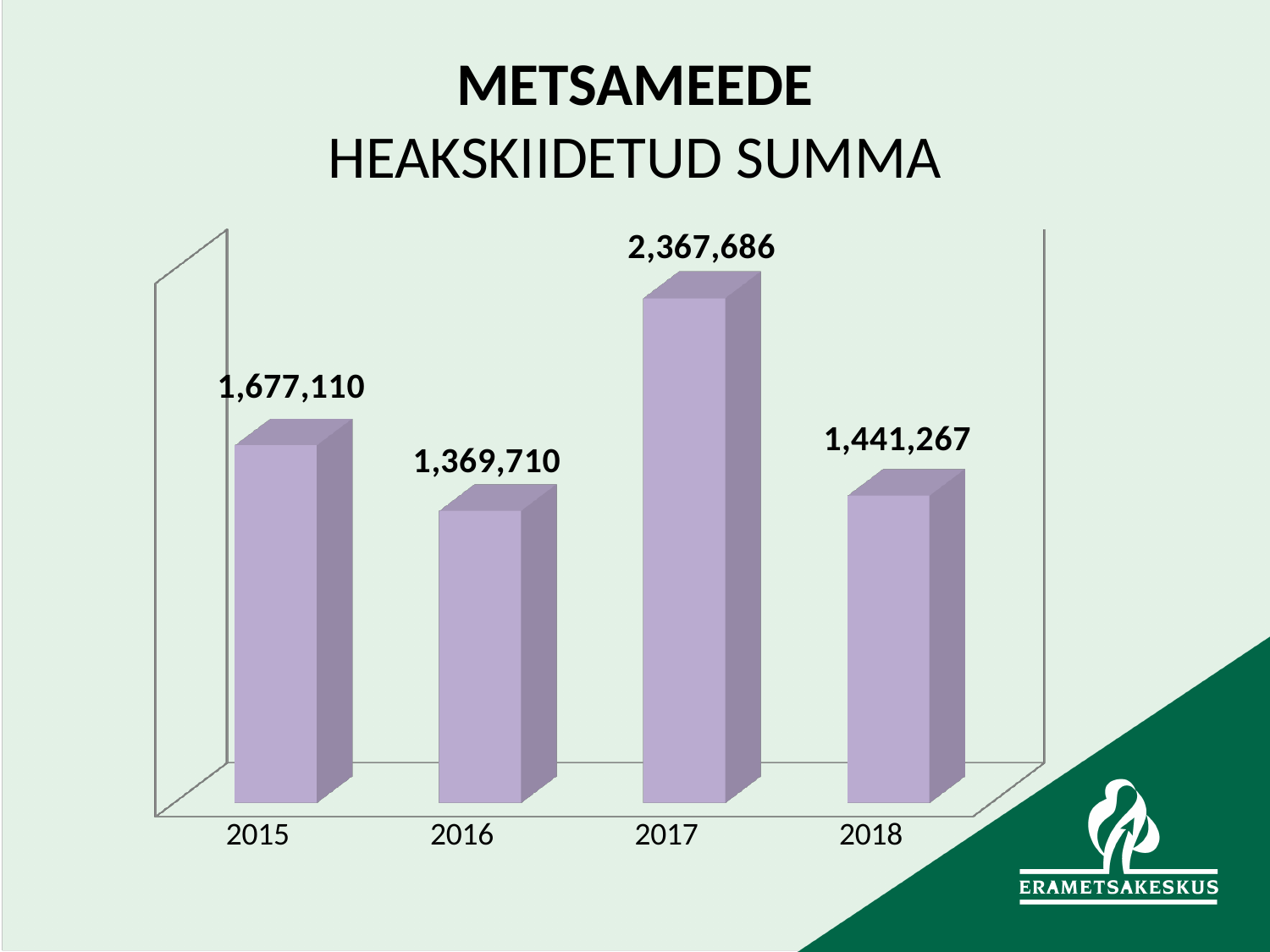
How many years are shown on the chart? 4 What kind of chart is shown on the slide? Bar chart What is the value for 2017? 2,367,686 What is the value for 2016? 1,369,710 What is the value for 2018? 1,441,267 Which is larger, the value for 2015 or the value for 2018? 2015 Which year has the highest value? 2017 Does the value rise or fall from 2017 to 2018? Fall What is the difference between the values for 2015 and 2016? 307,400 What is the difference between the values for 2017 and 2015? 690,576 What is the value for 2015? 1,677,110 Which year has the lowest value? 2016